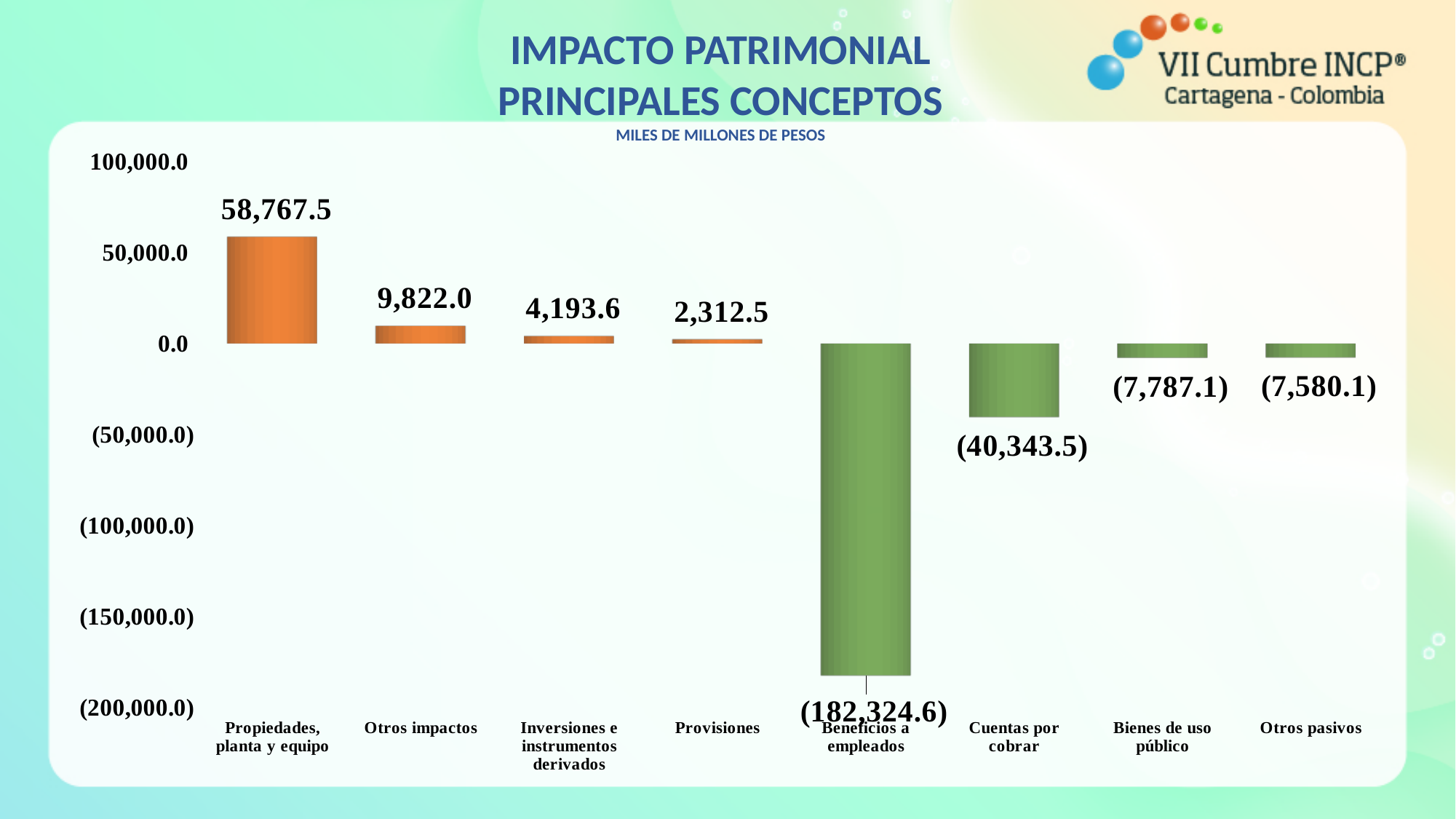
How many categories are shown in the chart? 8 What is the value for Propiedades, planta y equipo? 58,767.5 What kind of chart is shown on the slide? Bar chart Which is larger, the value for Otros impactos or the value for Provisiones? Otros impactos Which category has the lowest value? Beneficios a empleados What is the value for Cuentas por cobrar? (40,343.5) Which category has the highest value? Propiedades, planta y equipo What is the difference between the values for Otros impactos and Inversiones e instrumentos derivados? 5,628.4 What is the value for Beneficios a empleados? (182,324.6) Is the value for Cuentas por cobrar greater or less than (50,000.0)? greater What is the value for Provisiones? 2,312.5 What is the difference between the values for Propiedades, planta y equipo and Otros impactos? 48,945.5